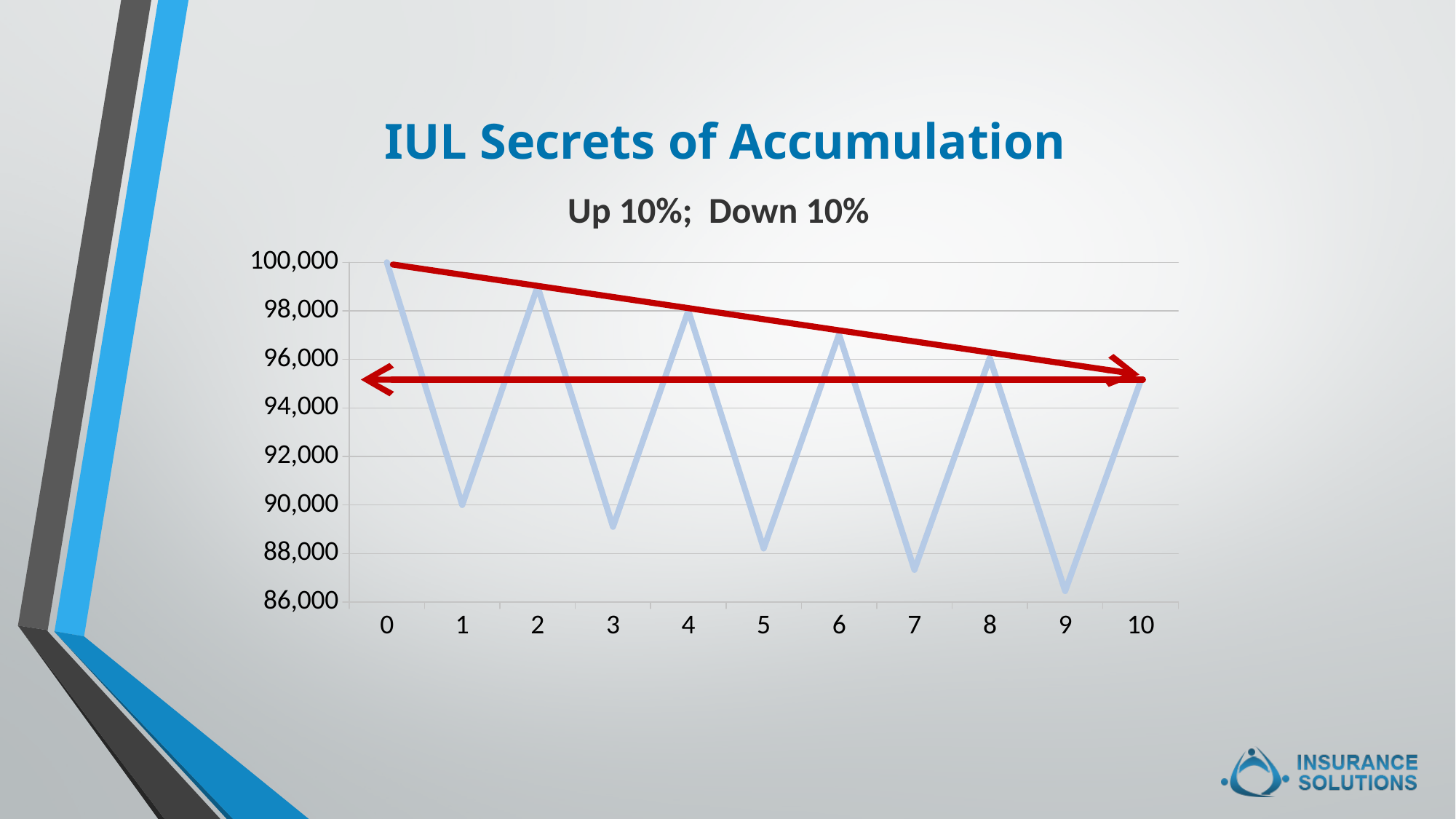
What kind of chart is shown on the slide? line chart Is the value at x = 2 greater or less than 98,000? greater Is the value at x = 9 greater or less than 88,000? less How many data points are plotted on the line (x values 0 through 10)? 11 Is the value at x = 3 greater or less than 90,000? less At which x value is the line at its highest point? 0 What is the value at x = 1? 90,000 At which x value is the line at its lowest point? 9 What is the title of the chart? Up 10%; Down 10% Do the peaks of the line rise or fall as x increases from 0 to 10? fall What is the value at x = 0? 100,000